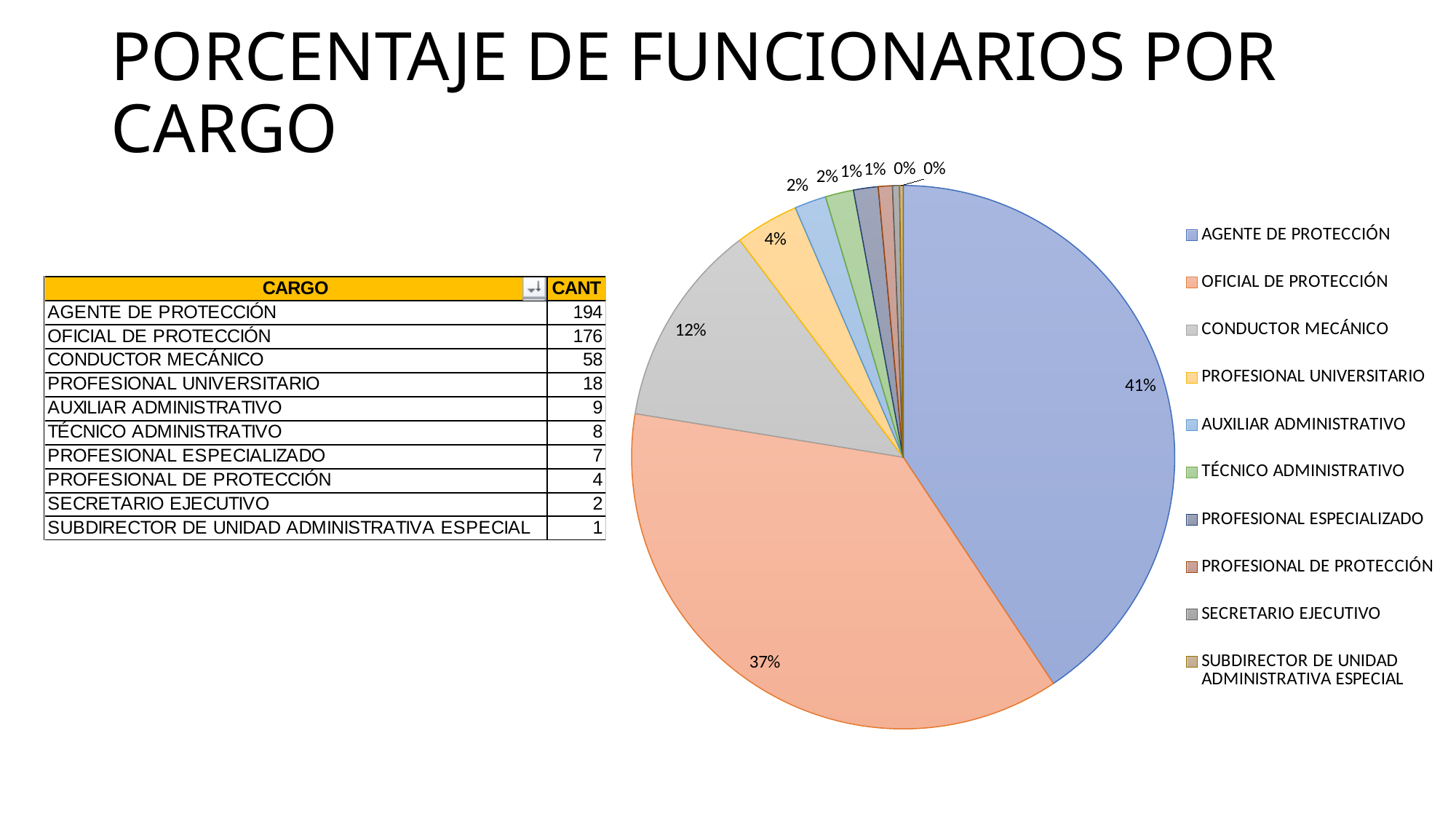
What share of the pie does PROFESIONAL UNIVERSITARIO represent? 4% Which slice is larger, OFICIAL DE PROTECCIÓN or CONDUCTOR MECÁNICO? OFICIAL DE PROTECCIÓN What colour is the AGENTE DE PROTECCIÓN slice in the pie chart? blue What share of the pie does AGENTE DE PROTECCIÓN represent? 41% What is the title of the slide containing the pie chart? PORCENTAJE DE FUNCIONARIOS POR CARGO How many categories does the legend of the pie chart list? 10 What is the difference in percentage points between the AGENTE DE PROTECCIÓN slice and the OFICIAL DE PROTECCIÓN slice? 4 Which category has the largest slice of the pie? AGENTE DE PROTECCIÓN What percentage label is shown for the SECRETARIO EJECUTIVO slice? 0% What type of chart is shown on the slide? pie chart